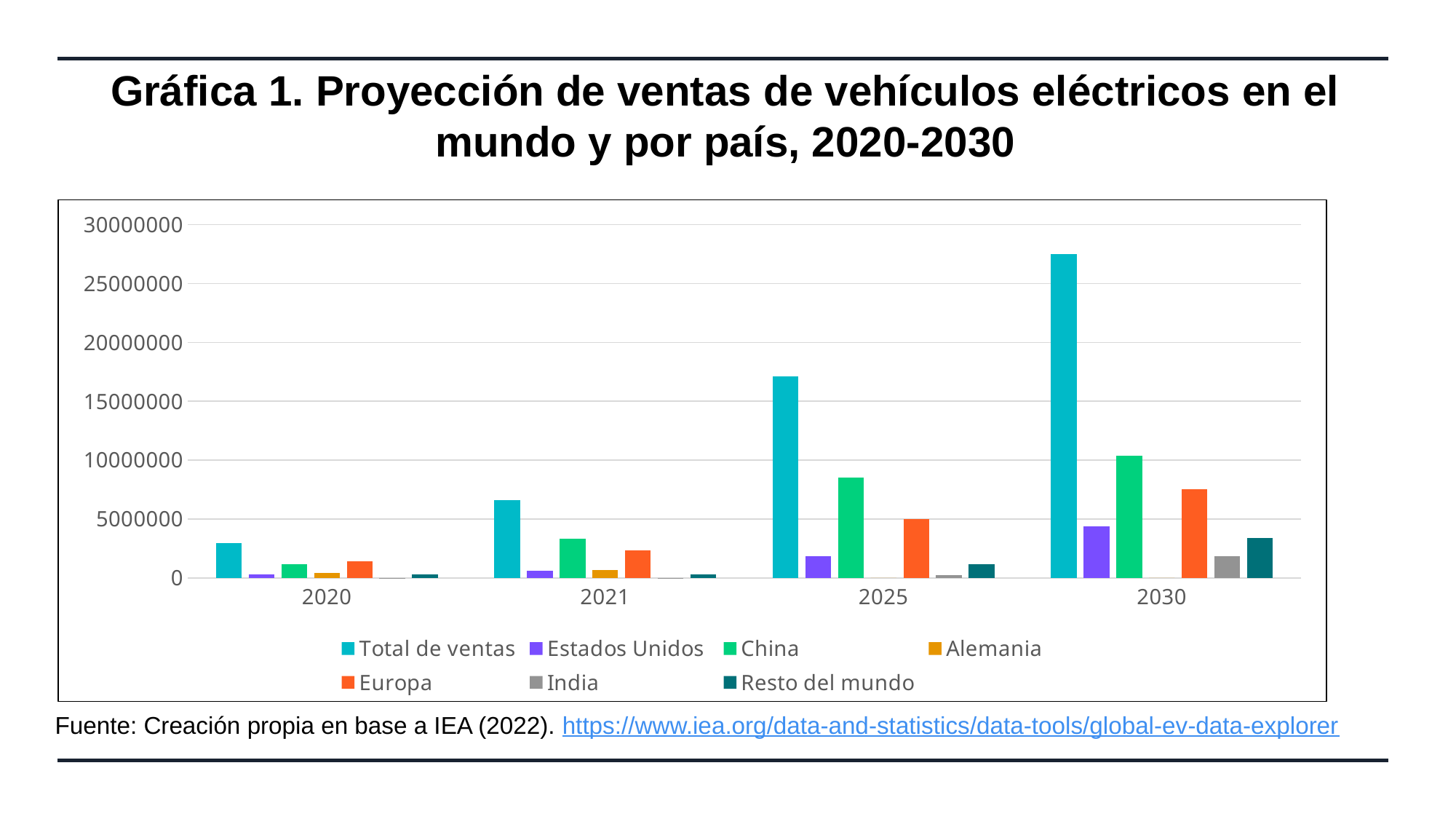
Is the value for China in 2030 greater or less than 5000000? greater Is the value for Europa in 2030 greater or less than 5000000? greater How many series does the legend list? 7 Is the value for Total de ventas in 2030 greater or less than 25000000? greater Does Total de ventas rise or fall from 2020 to 2030? rise In 2030, which is larger, China or Europa? China In which year is Total de ventas highest? 2030 What kind of chart is shown on the slide? bar chart What is the title of the chart? Gráfica 1. Proyección de ventas de vehículos eléctricos en el mundo y por país, 2020-2030 How many years are shown on the x axis? 4